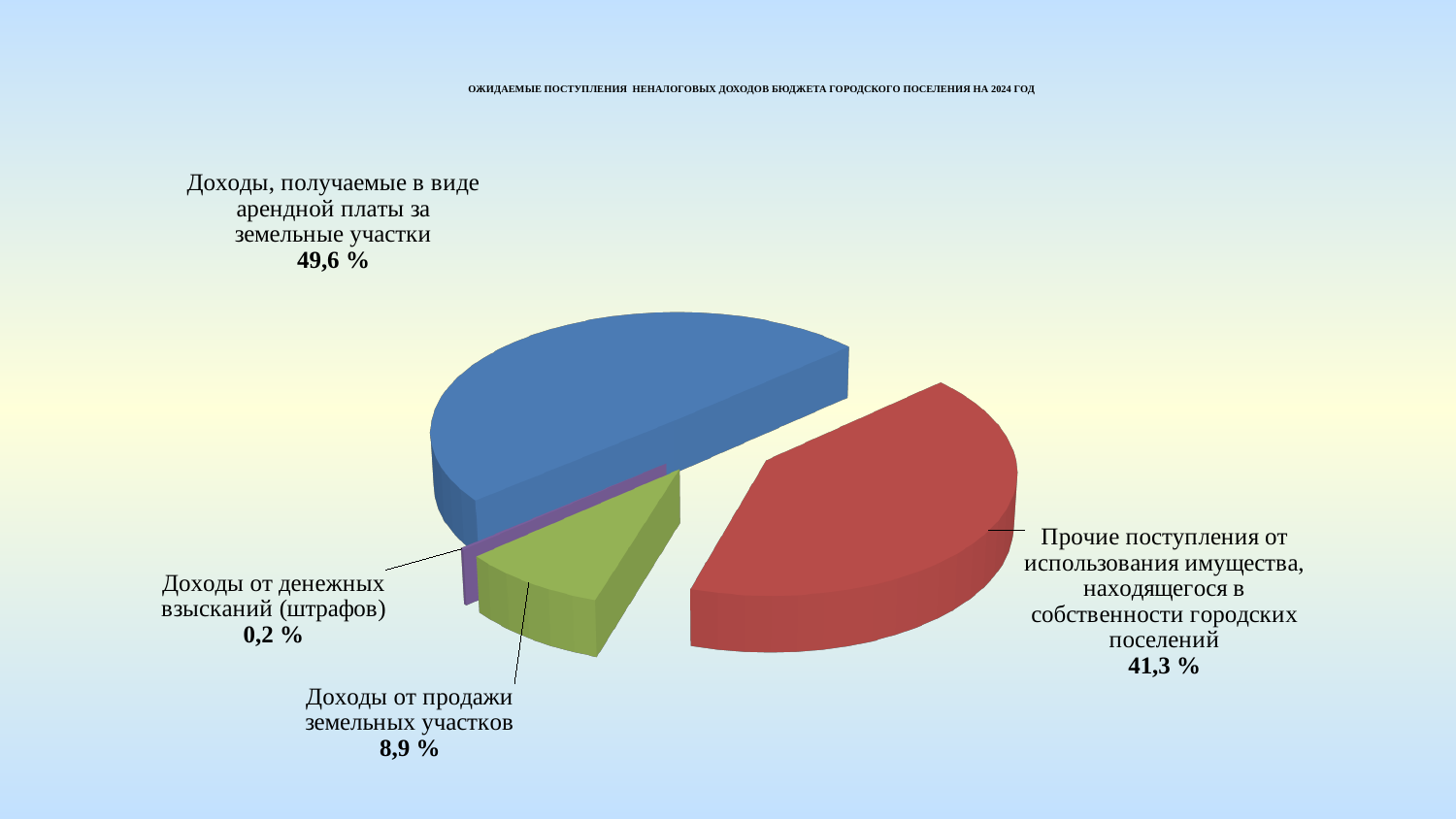
Which category has the smallest share of the pie? Доходы от денежных взысканий (штрафов) What share is shown for 'Доходы от продажи земельных участков'? 8,9 % What share is shown for 'Прочие поступления от использования имущества, находящегося в собственности городских поселений'? 41,3 % What share is shown for 'Доходы от денежных взысканий (штрафов)'? 0,2 % What kind of chart is shown on the slide? Pie chart Which category has the largest share of the pie? Доходы, получаемые в виде арендной платы за земельные участки What is the difference in percentage points between the share for rental income from land plots (49,6 %) and the share for other income from use of property (41,3 %)? 8,3 What share of the pie is labelled for 'Доходы, получаемые в виде арендной платы за земельные участки'? 49,6 % How many slices does the pie chart have? 4 What year does the chart title say the expected non-tax budget revenues are for? 2024 What colour is the slice representing 'Прочие поступления от использования имущества, находящегося в собственности городских поселений'? Red Which is larger: the share for 'Доходы от продажи земельных участков' or the share for 'Доходы от денежных взысканий (штрафов)'? Доходы от продажи земельных участков